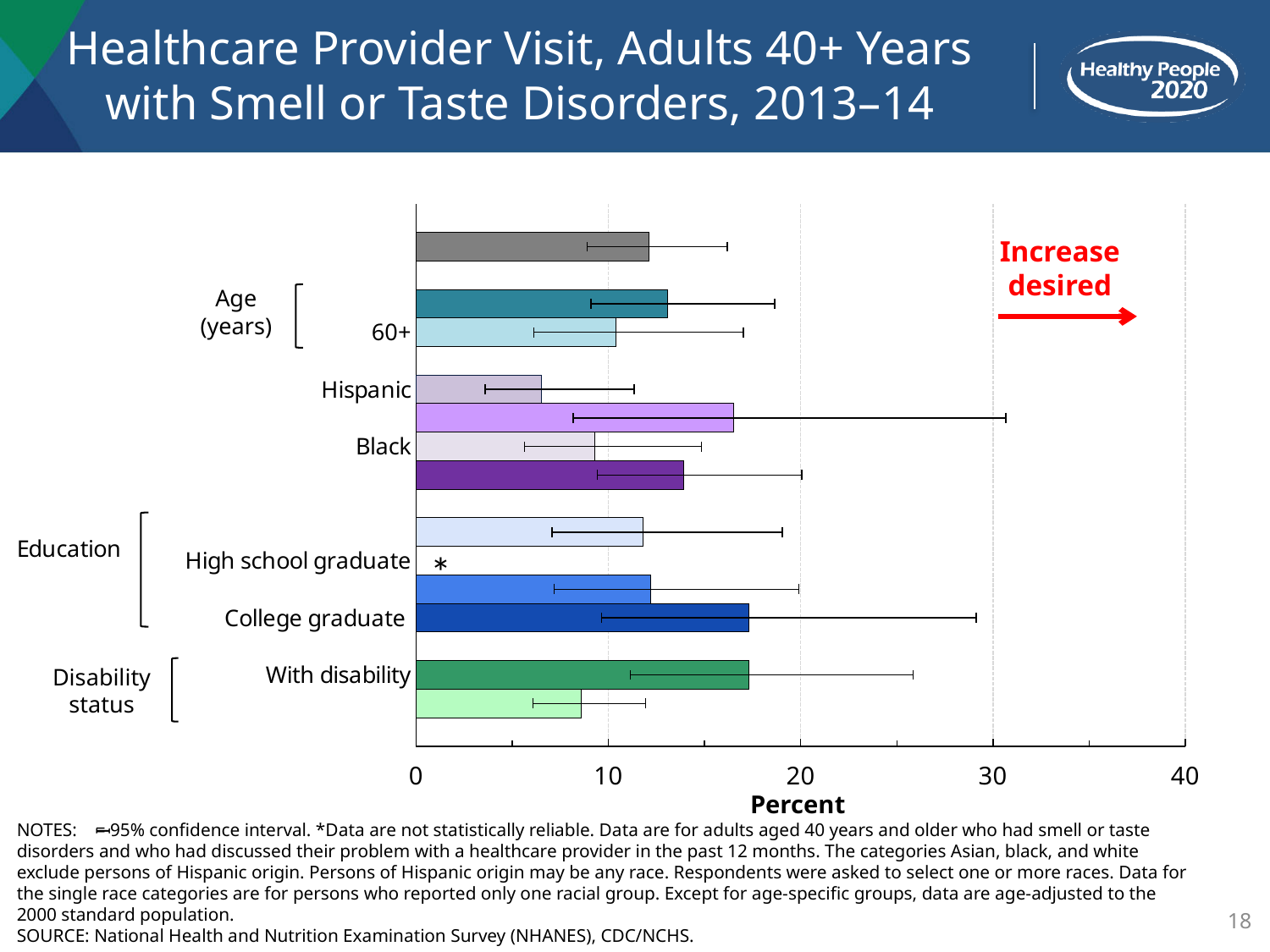
Is the value for With disability greater or less than 20? less Is the value for Hispanic greater or less than 10? less Which has the larger value, Black or Hispanic? Black Is the value for With disability greater or less than 10? greater Which has the larger value, 60+ or Hispanic? 60+ What kind of chart is shown on the slide? bar chart Which has the larger value, College graduate or Hispanic? College graduate What does the asterisk next to High school graduate indicate? Data are not statistically reliable What is the label of the horizontal axis? Percent